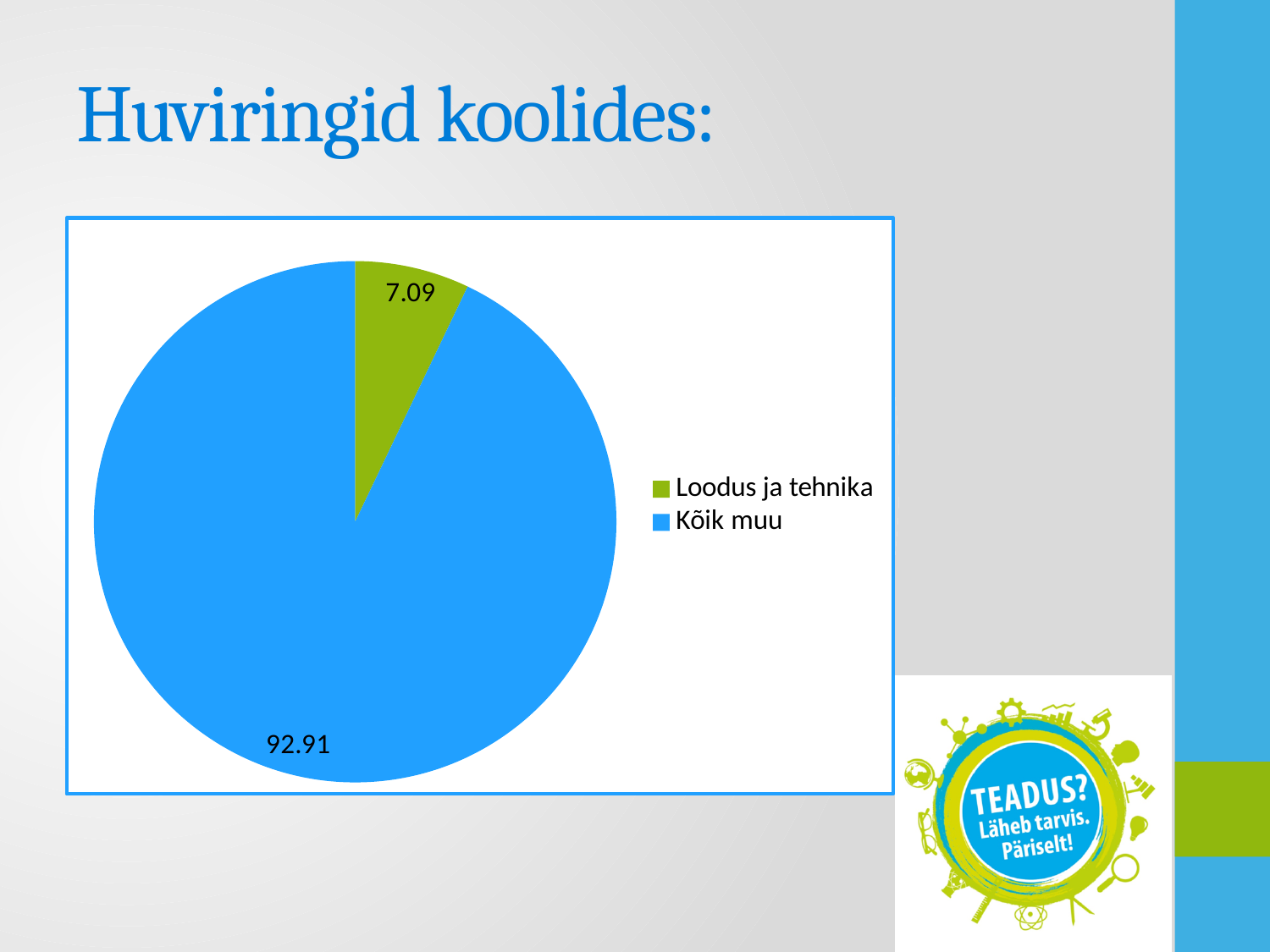
What kind of chart is shown on the slide? pie chart How many entries does the legend list? 2 What colour is the Loodus ja tehnika slice? green What share of the pie does Loodus ja tehnika take? 7.09 Which category has the largest slice? Kõik muu What is the difference between the values for Kõik muu and Loodus ja tehnika? 85.82 What is the value for Loodus ja tehnika? 7.09 What is the value for Kõik muu? 92.91 Which category has the smallest slice? Loodus ja tehnika Which is larger, Loodus ja tehnika or Kõik muu? Kõik muu How many slices does the pie chart have? 2 What is the title of the slide containing the chart? Huviringid koolides: